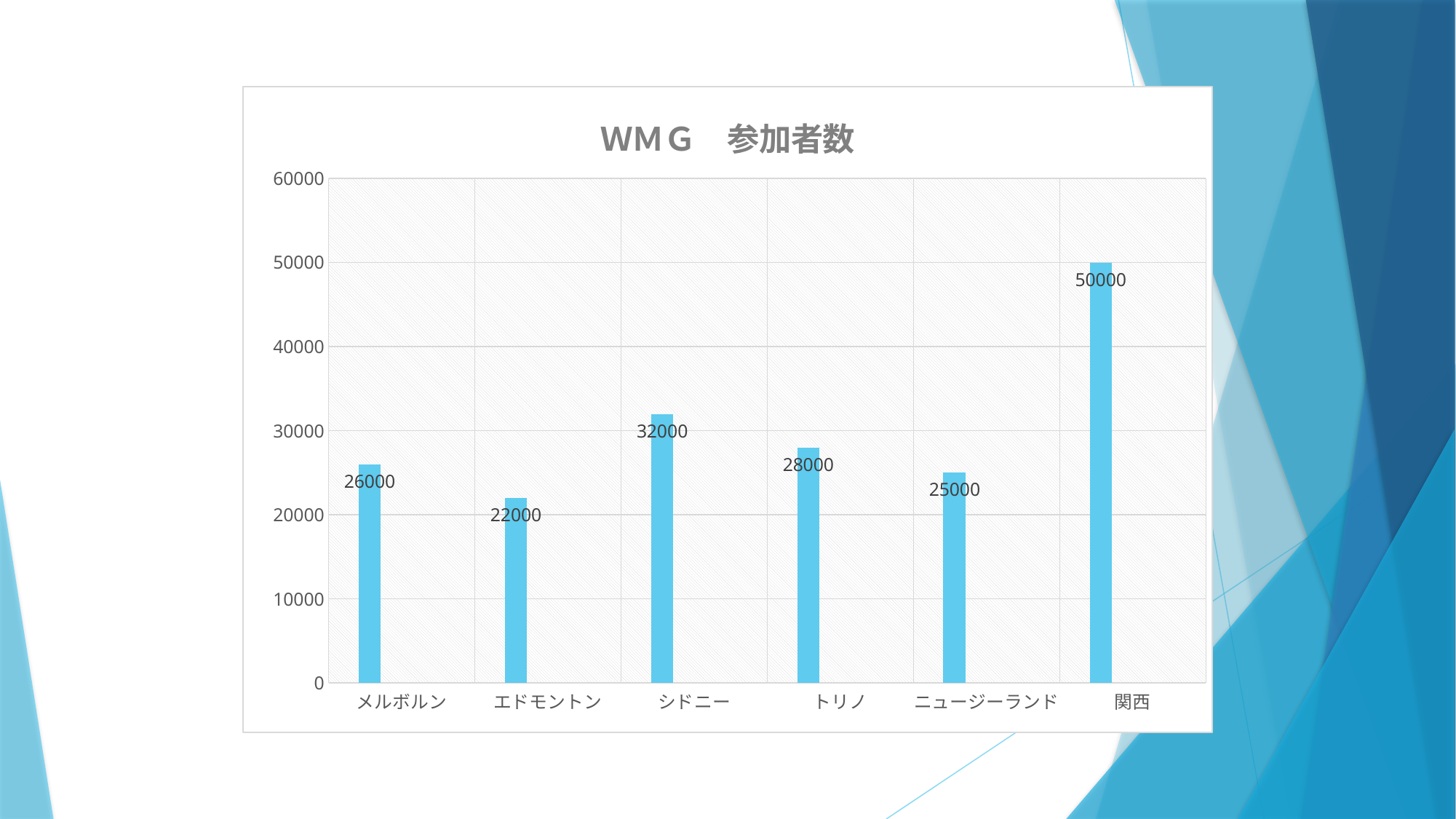
What is the value for シドニー? 32000 What is the difference between the values for メルボルン and エドモントン? 4000 How many categories are shown on the x axis? 6 What is the value for エドモントン? 22000 Which category has the highest value? 関西 What kind of chart is shown on the slide? bar chart Is the value for 関西 greater or less than 40000? greater What is the value for ニュージーランド? 25000 What is the title of the chart? WMG 参加者数 Which category has the lowest value? エドモントン Which is larger, the value for トリノ or the value for ニュージーランド? トリノ What is the difference between the values for 関西 and シドニー? 18000